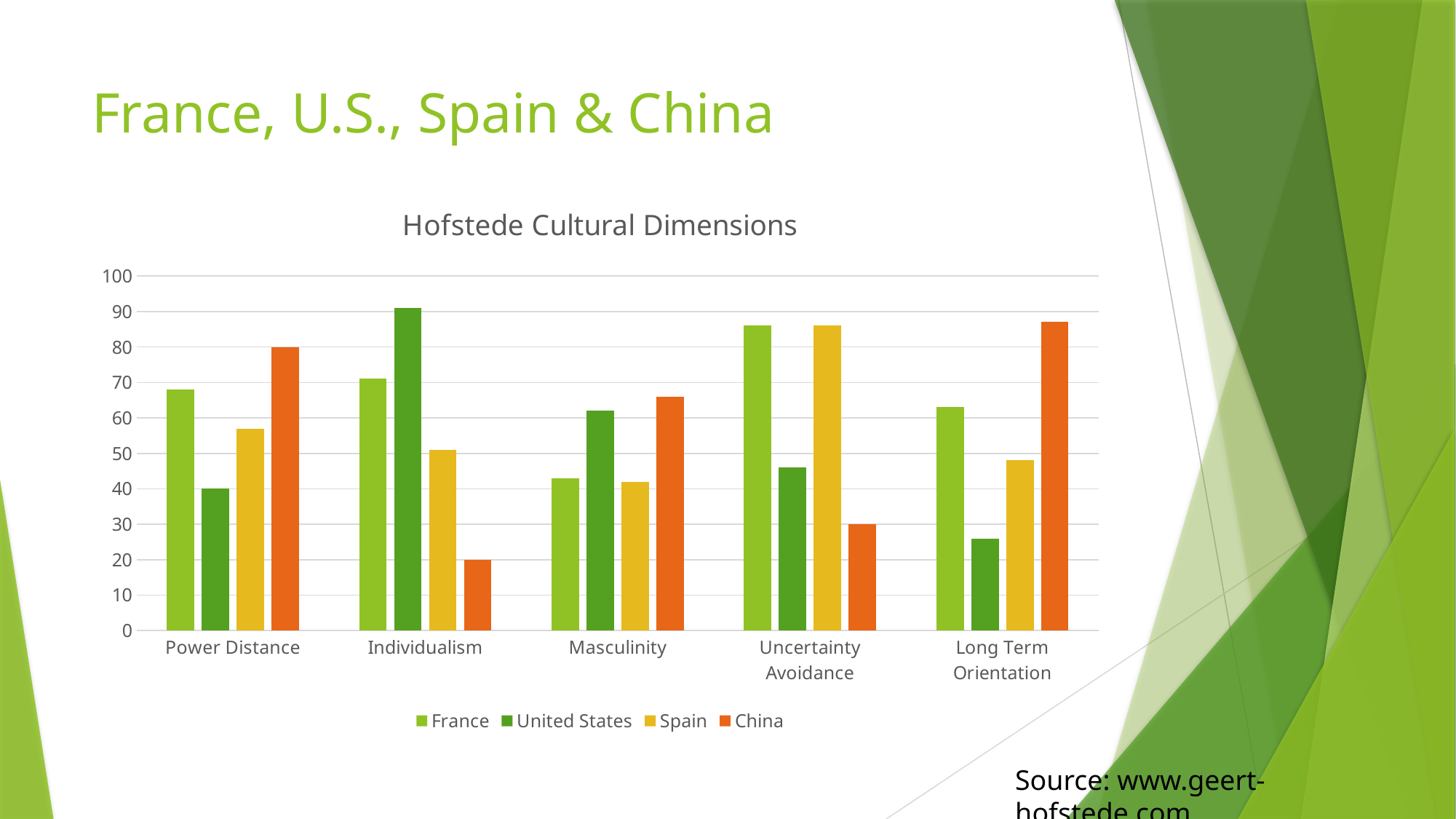
How many series does the legend list? 4 What is the title of the chart? Hofstede Cultural Dimensions Which country has the lowest value for Power Distance? United States How many cultural dimension categories are shown on the x axis? 5 Which country has the highest value for Long Term Orientation? China Which country has the highest value for Individualism? United States Which country has the lowest value for Uncertainty Avoidance? China For Power Distance, which is larger: France or United States? France Is the value for United States in Long Term Orientation greater or less than 30? less What kind of chart is shown on the slide? bar chart Is the value for Spain in Masculinity greater or less than 50? less Is the value for China in Long Term Orientation greater or less than 80? greater